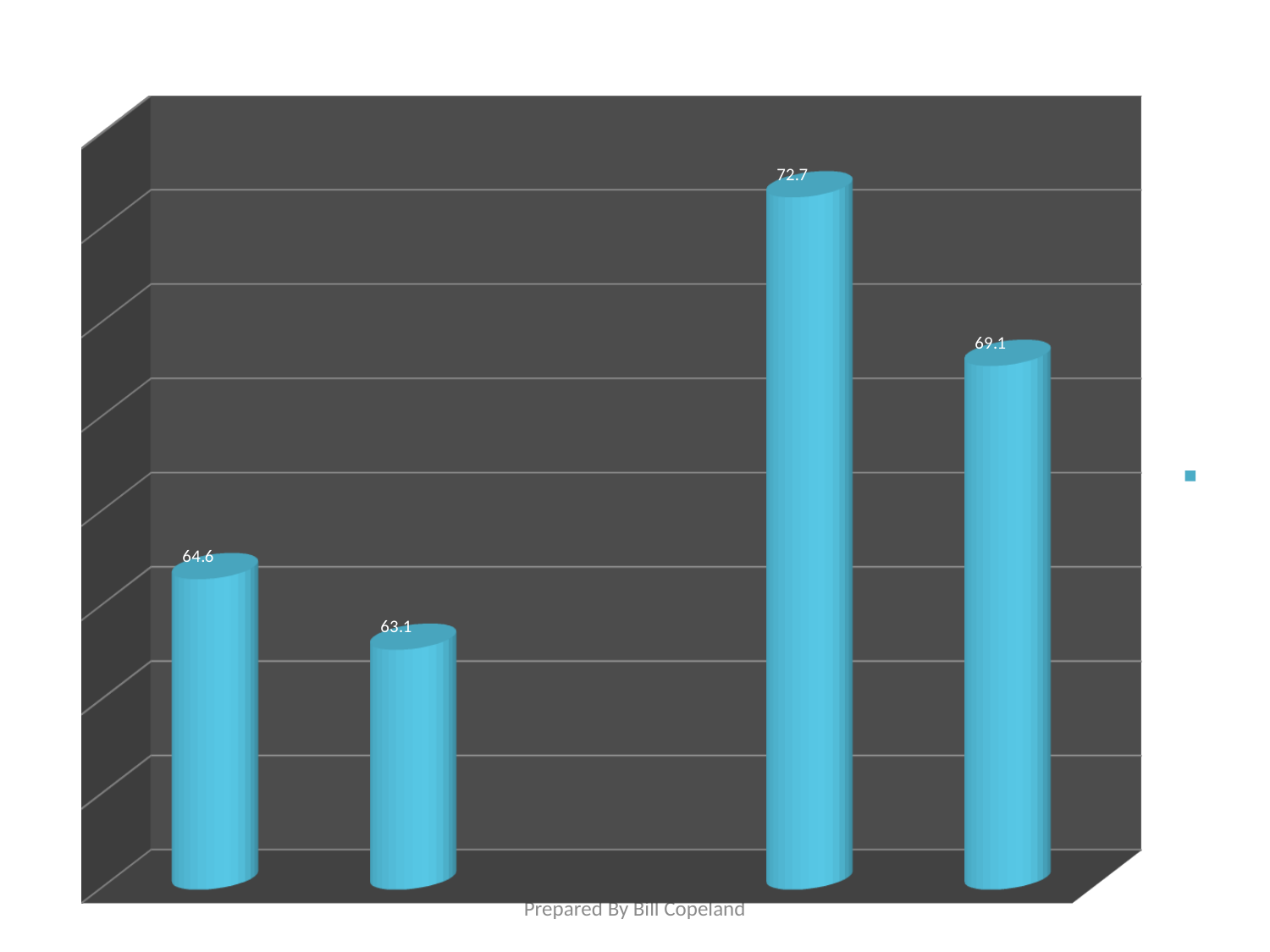
How many bars are plotted in the chart? 4 What is the value shown on the second bar from the left? 63.1 What is the value shown on the first bar from the left? 64.6 Which bar has the highest value? The third bar from the left (72.7) What is the difference between the third bar (72.7) and the fourth bar (69.1)? 3.6 What is the difference between the highest and lowest bar values? 9.6 What is the value shown on the fourth bar from the left? 69.1 What kind of chart is shown on the slide? Bar chart Which bar has the lowest value? The second bar from the left (63.1) How many series does the legend list? 1 Which is larger, the value of the first bar or the value of the fourth bar? The fourth bar (69.1) What is the value shown on the third bar from the left? 72.7